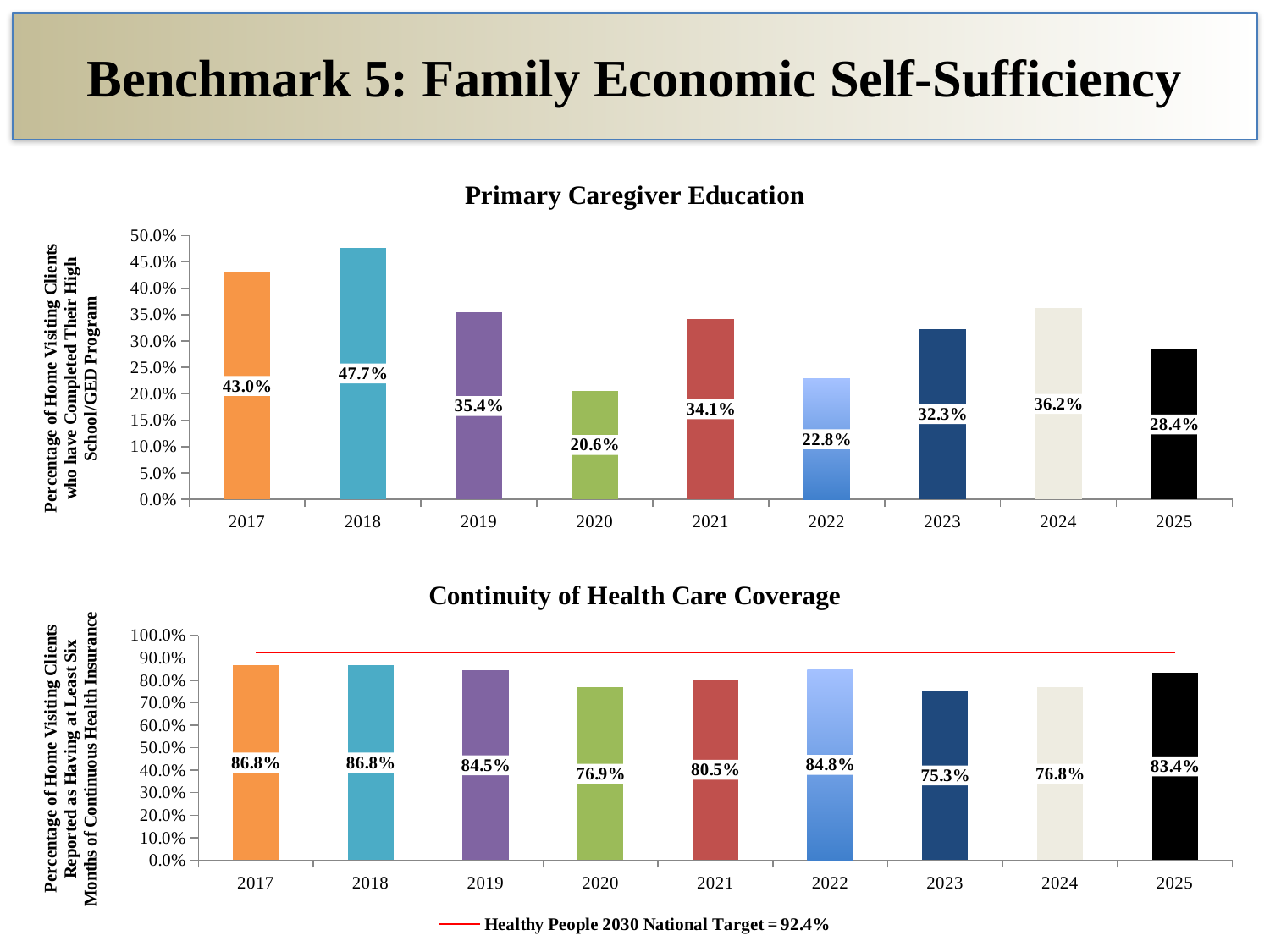
In the Continuity of Health Care Coverage chart, which year has the lowest value? 2023 In the Primary Caregiver Education chart, which year has the highest value? 2018 In the Primary Caregiver Education chart, which year has the lowest value? 2020 In the Continuity of Health Care Coverage chart, is the value for 2025 greater or less than 2024? greater What kind of chart is the Continuity of Health Care Coverage chart? Bar chart In the Continuity of Health Care Coverage chart, what is the value for 2023? 75.3% In the Primary Caregiver Education chart, is the value for 2024 greater or less than 2023? greater How many years are shown in the Primary Caregiver Education chart? 9 In the Continuity of Health Care Coverage chart, what is the difference between the 2022 and 2020 values? 7.9% In the Continuity of Health Care Coverage chart, what is the Healthy People 2030 National Target shown by the red line? 92.4% In the Primary Caregiver Education chart, what is the value for 2018? 47.7% In the Primary Caregiver Education chart, what is the difference between the 2017 and 2025 values? 14.6%